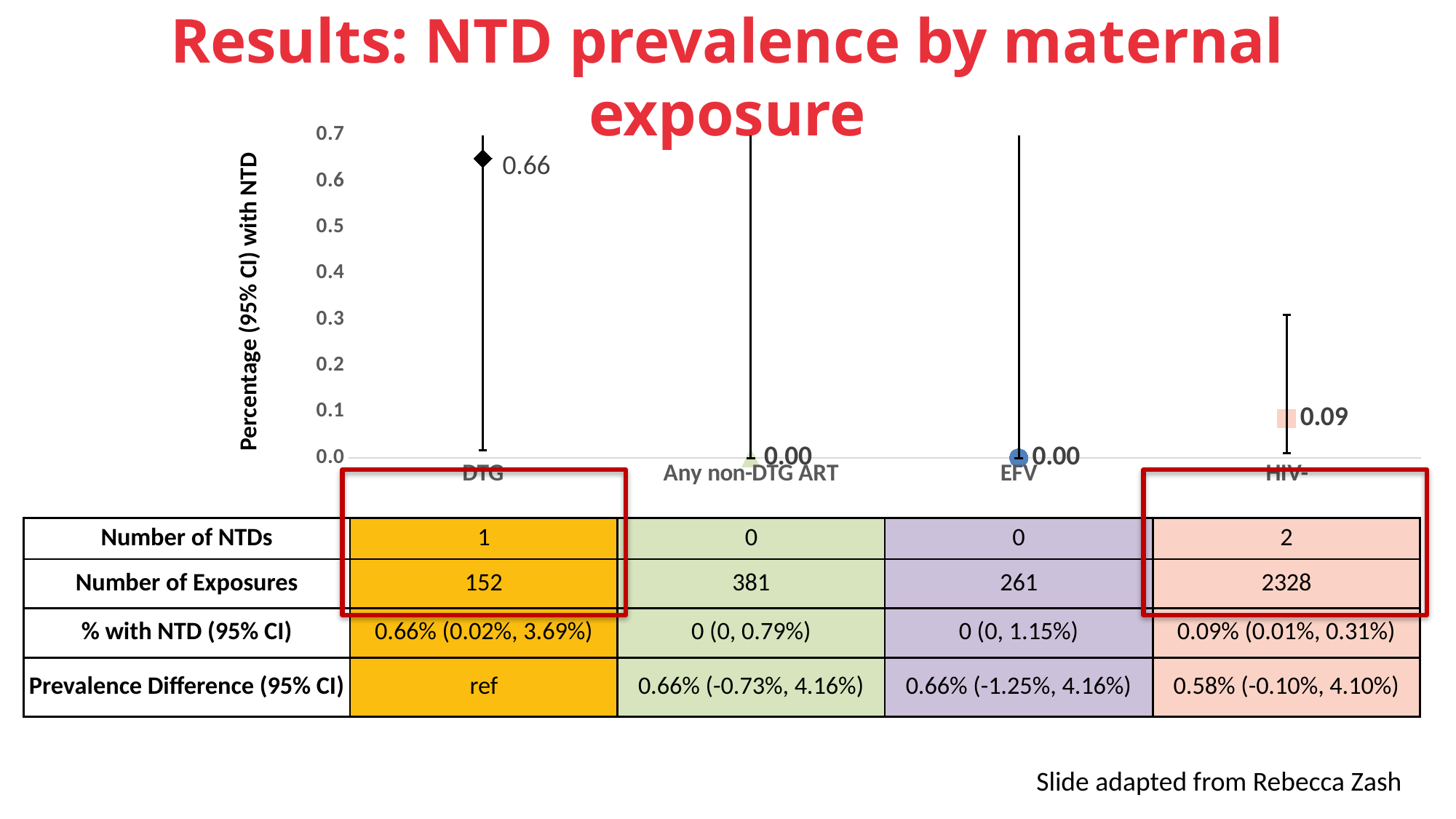
Which is larger, the plotted value for DTG or for HIV-? DTG Which category has the highest plotted percentage with NTD? DTG What is the plotted value for Any non-DTG ART? 0.00 What is the plotted value for DTG? 0.66 What is the plotted value for HIV-? 0.09 How many exposure categories are shown on the x axis? 4 What is the label of the y axis? Percentage (95% CI) with NTD What is the plotted value for EFV? 0.00 What is the maximum value shown on the y axis? 0.7 Is the plotted value for DTG greater or less than 0.5? greater What is the difference between the plotted values for DTG and HIV-? 0.57 Is the plotted value for HIV- greater or less than 0.2? less